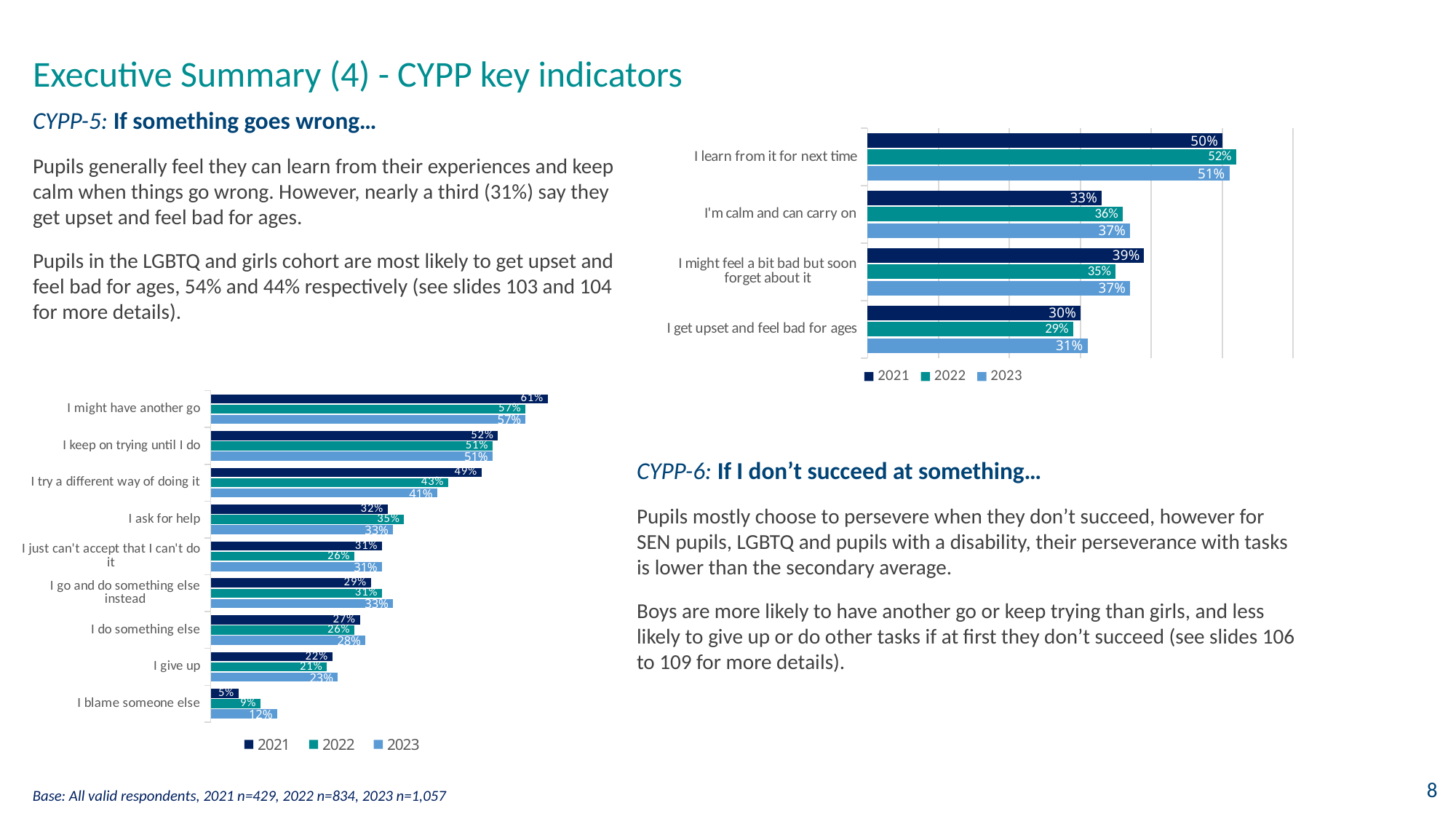
In the top-right chart, what is the 2023 value for "I get upset and feel bad for ages"? 31% In the bottom-left chart, what is the 2023 value for "I blame someone else"? 12% In the top-right chart, what is the 2022 value for "I learn from it for next time"? 52% In the bottom-left chart, what is the 2021 value for "I might have another go"? 61% What kind of chart is the top-right chart? bar chart In the top-right chart, how many series does the legend list? 3 In the top-right chart, which category has the highest 2021 value? I learn from it for next time In the bottom-left chart, which category has the lowest 2021 value? I blame someone else In the bottom-left chart, do the values for "I blame someone else" rise or fall from 2021 to 2023? rise In the bottom-left chart, is the 2022 value for "I ask for help" larger or smaller than the 2022 value for "I go and do something else instead"? larger In the bottom-left chart, how many categories are shown? 9 In the top-right chart, what is the difference between the 2021 and 2022 values for "I might feel a bit bad but soon forget about it"? 4%